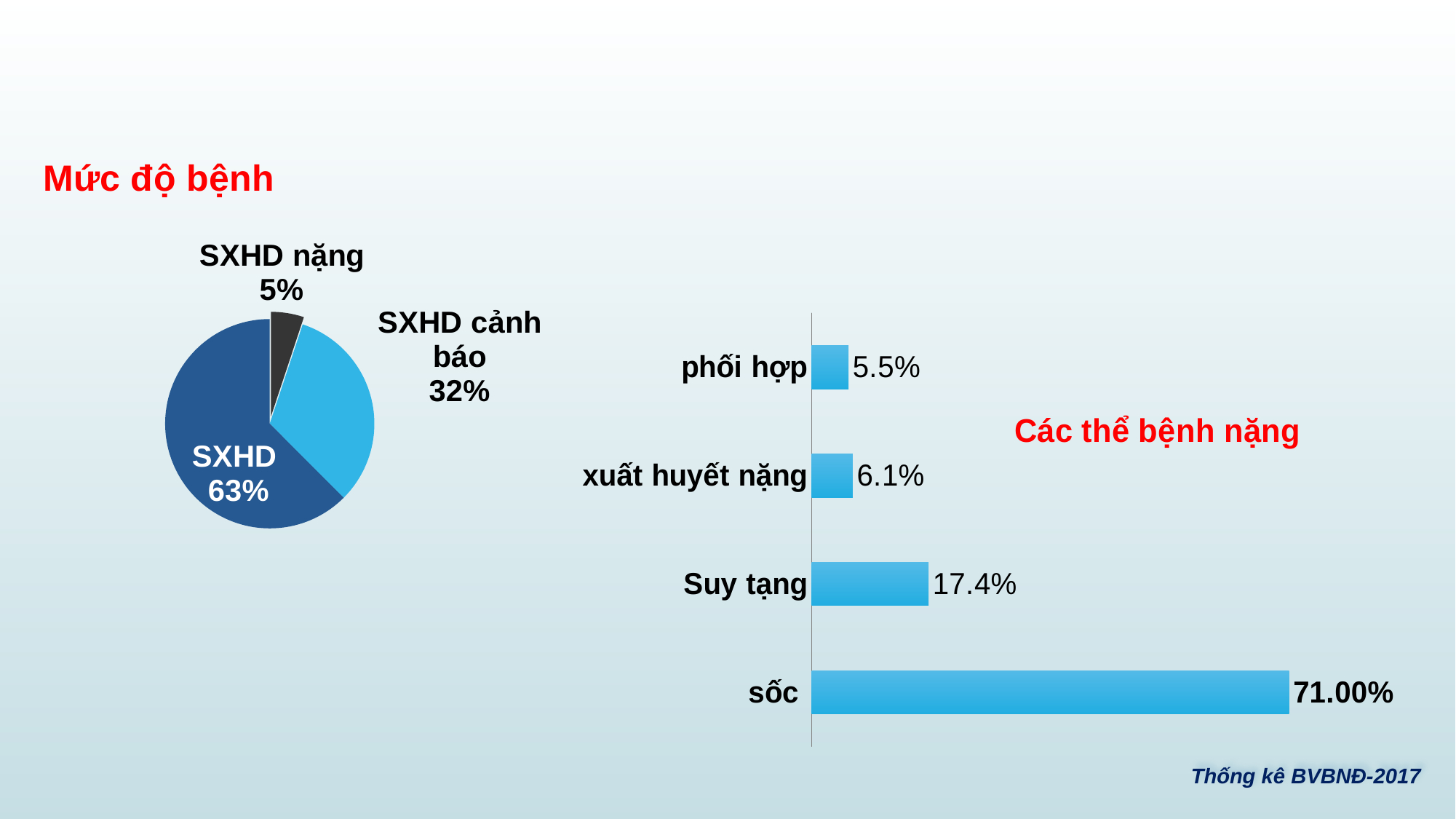
In the bar chart on the right (Các thể bệnh nặng), what is the value for sốc? 71.00% What kind of chart is the chart on the right (Các thể bệnh nặng)? Bar chart In the pie chart on the left (Mức độ bệnh), what share does SXHD cảnh báo have? 32% In the bar chart on the right (Các thể bệnh nặng), what is the difference between Suy tạng and xuất huyết nặng? 11.3% In the bar chart on the right (Các thể bệnh nặng), what is the value for Suy tạng? 17.4% In the bar chart on the right (Các thể bệnh nặng), which is larger, xuất huyết nặng or phối hợp? xuất huyết nặng In the pie chart on the left (Mức độ bệnh), how many slices are there? 3 In the pie chart on the left (Mức độ bệnh), what share does SXHD have? 63% In the bar chart on the right (Các thể bệnh nặng), what is the value for phối hợp? 5.5% What kind of chart is the chart on the left (Mức độ bệnh)? Pie chart In the pie chart on the left (Mức độ bệnh), which category has the smallest slice? SXHD nặng In the bar chart on the right (Các thể bệnh nặng), which category has the lowest value? phối hợp